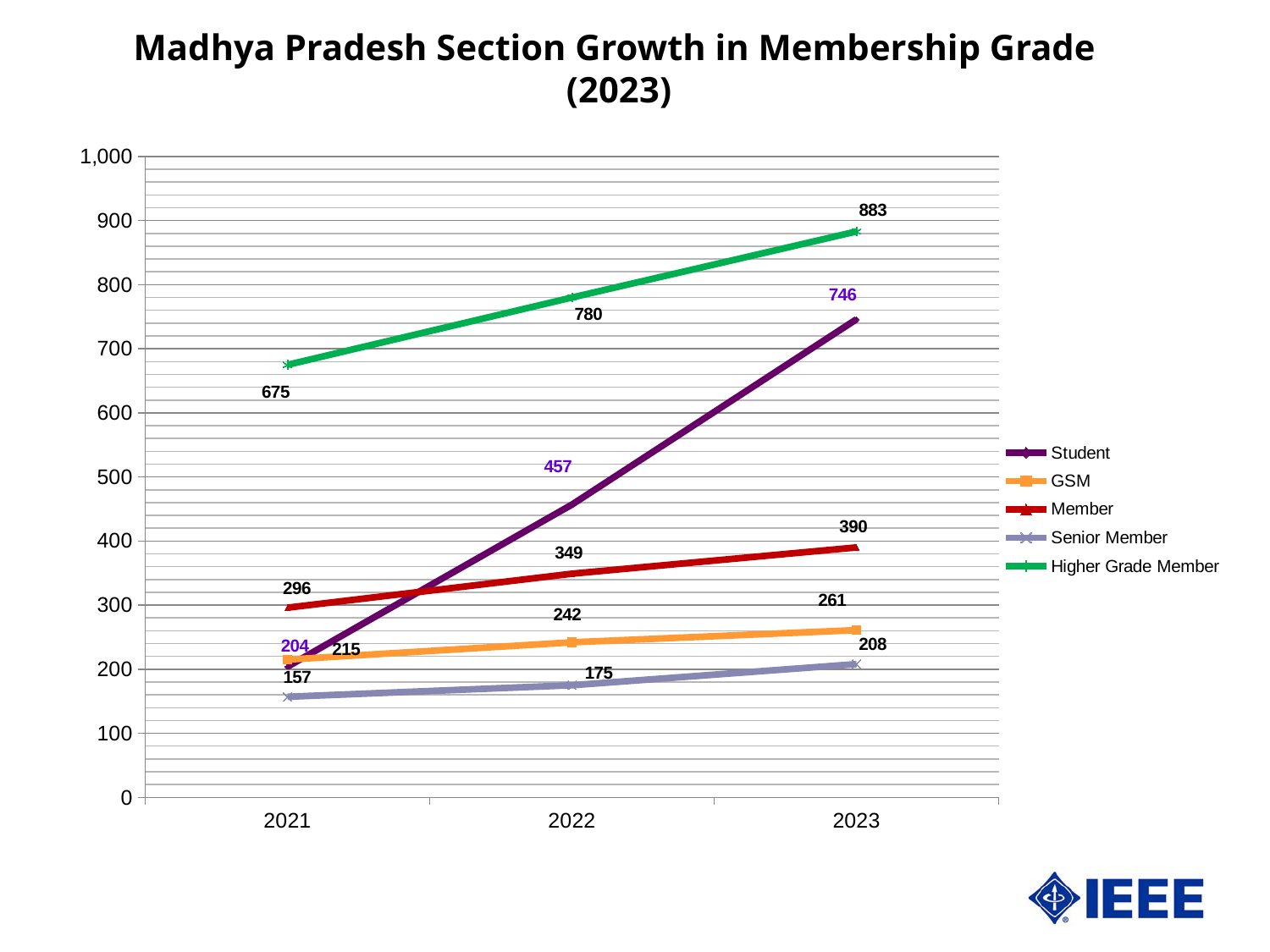
How many series does the legend list? 5 How many years are shown on the x axis? 3 What is the value for Higher Grade Member in 2021? 675 Does the Member series rise or fall from 2021 to 2023? rise What is the value for Student in 2023? 746 Which is larger in 2022, the Member value or the GSM value? Member Which series has the highest value in 2023? Higher Grade Member What is the value for GSM in 2023? 261 What is the value for Senior Member in 2022? 175 Which series has the lowest value in 2021? Senior Member What type of chart is shown on the slide? line chart What is the difference between the Student values in 2023 and 2021? 542